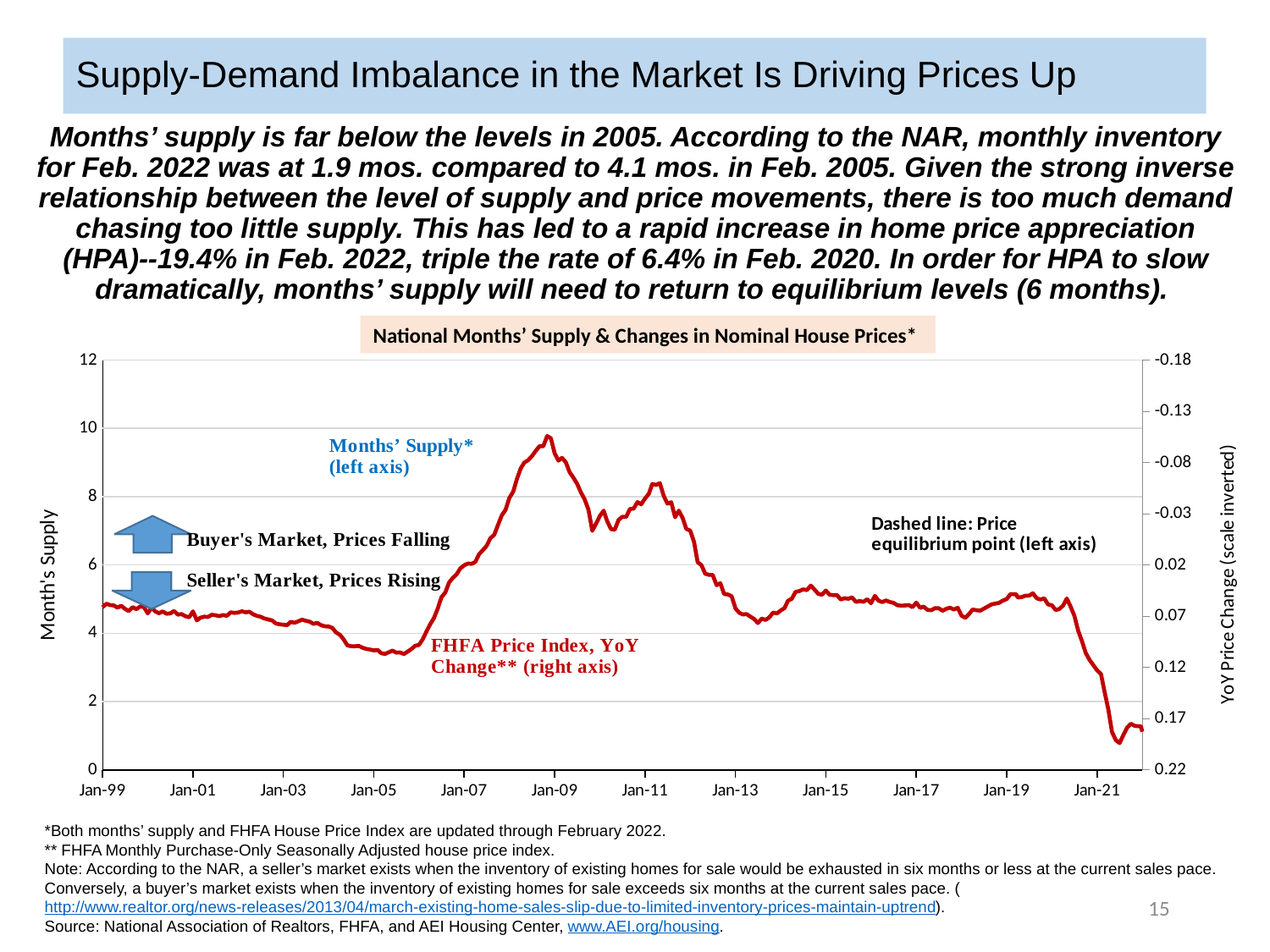
At what value on the left axis is the dashed price equilibrium line drawn? 6 What is the title of the chart? National Months' Supply & Changes in Nominal House Prices* Does the red line rise or fall between Jan-07 and Jan-09? rise What is the last label on the x axis? Jan-21 How many labeled tick marks are on the x axis? 12 How many series are labeled on the chart? 3 What kind of chart is shown on the slide? line chart Is the red line at Jan-05 greater or less than 6 on the left axis scale? less Is the peak of the red line near Jan-09 greater or less than 8 on the left axis scale? greater Does the red line rise or fall between Jan-19 and Jan-21? fall What is the first label on the x axis? Jan-99 What is the label of the left vertical axis? Month's Supply